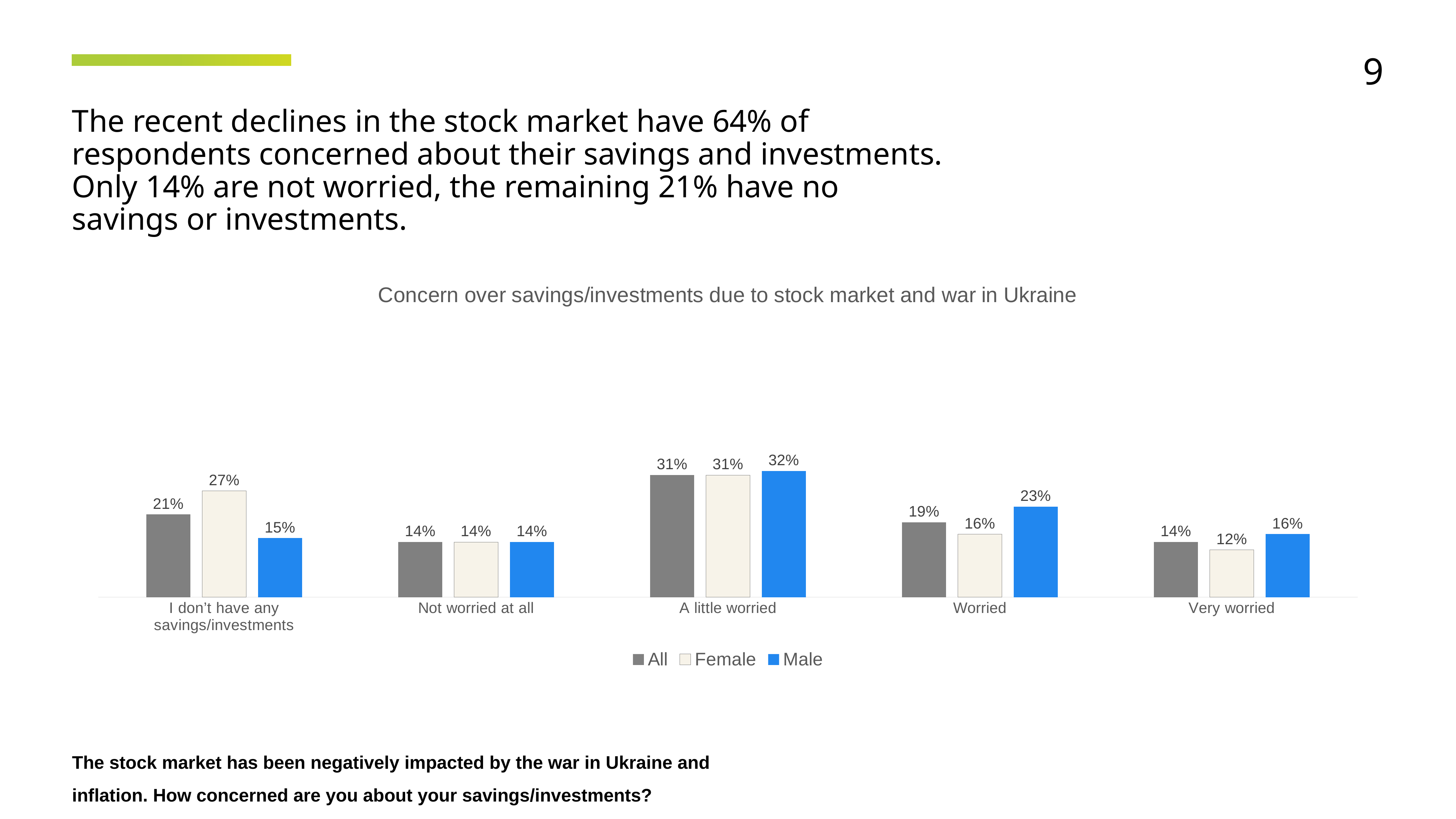
Which is larger in the "Worried" category: the Female value or the Male value? Male What is the title of the chart? Concern over savings/investments due to stock market and war in Ukraine How many series does the legend list? 3 What kind of chart is shown on the slide? Bar chart Which category has the highest value for the All series? A little worried How many categories are shown on the x axis? 5 What is the value for Female in the "I don't have any savings/investments" category? 27% Which category has the lowest value for the Female series? Very worried What is the difference between the Female and Male values in the "I don't have any savings/investments" category? 12% Which series is shown in blue? Male What is the value for Male in the "Worried" category? 23% What is the value for All in the "Very worried" category? 14%